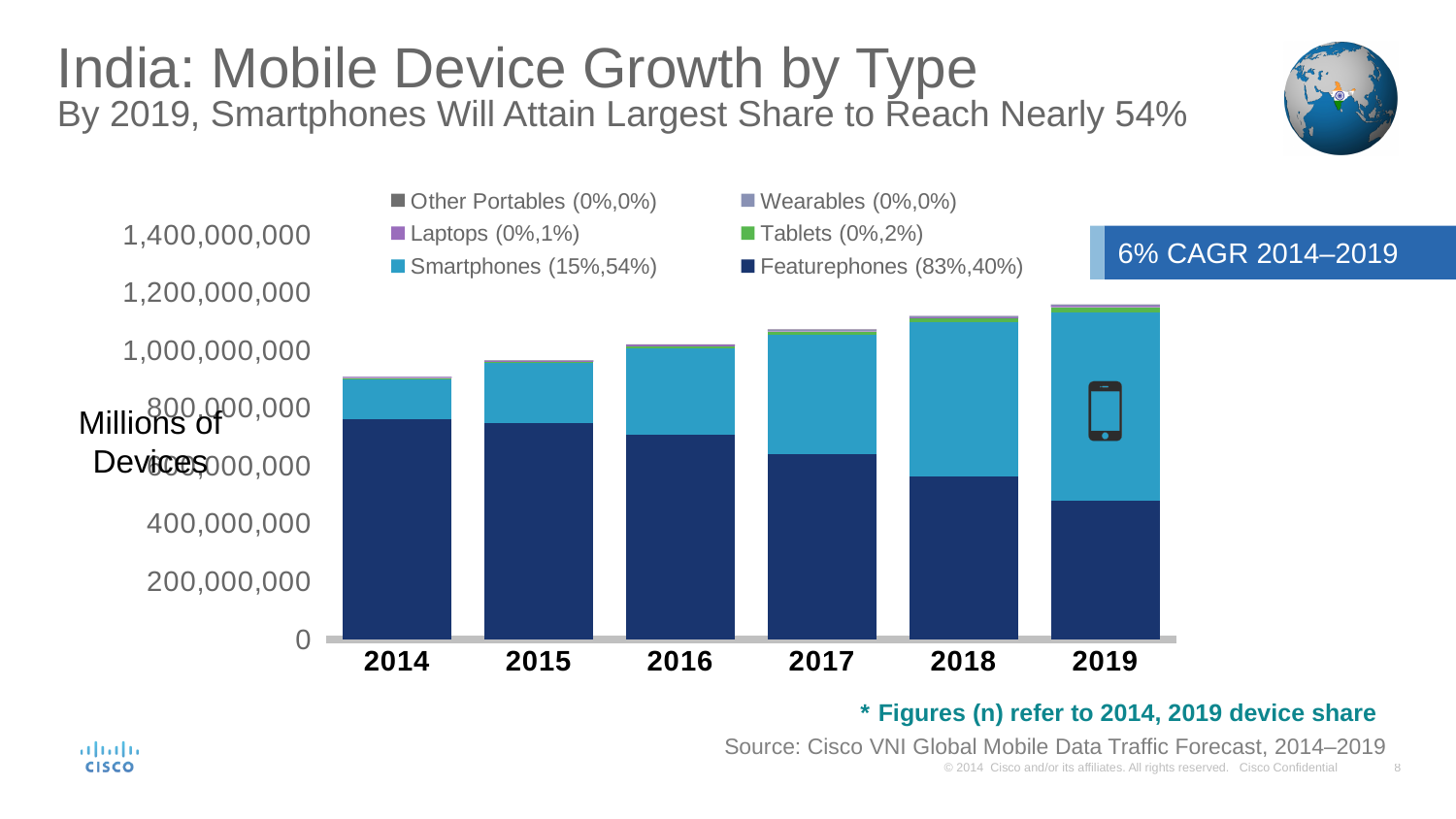
How many series does the chart's legend list? 6 Is the Featurephones value for 2014 greater or less than 600,000,000? greater Is the total bar for 2019 greater or less than 1,000,000,000? greater How many years are shown along the x axis of the chart? 6 Does the Featurephones segment rise or fall from 2014 to 2019? Fall Which is larger, the Featurephones value in 2014 or in 2019? 2014 Does the total bar height rise or fall from 2014 to 2019? Rise What kind of chart is shown on the slide? Stacked bar chart Is the Featurephones value for 2019 greater or less than 600,000,000? less Which year has the tallest total bar? 2019 What CAGR for 2014–2019 is stated in the box on the chart? 6% CAGR 2014–2019 Which year has the shortest total bar? 2014